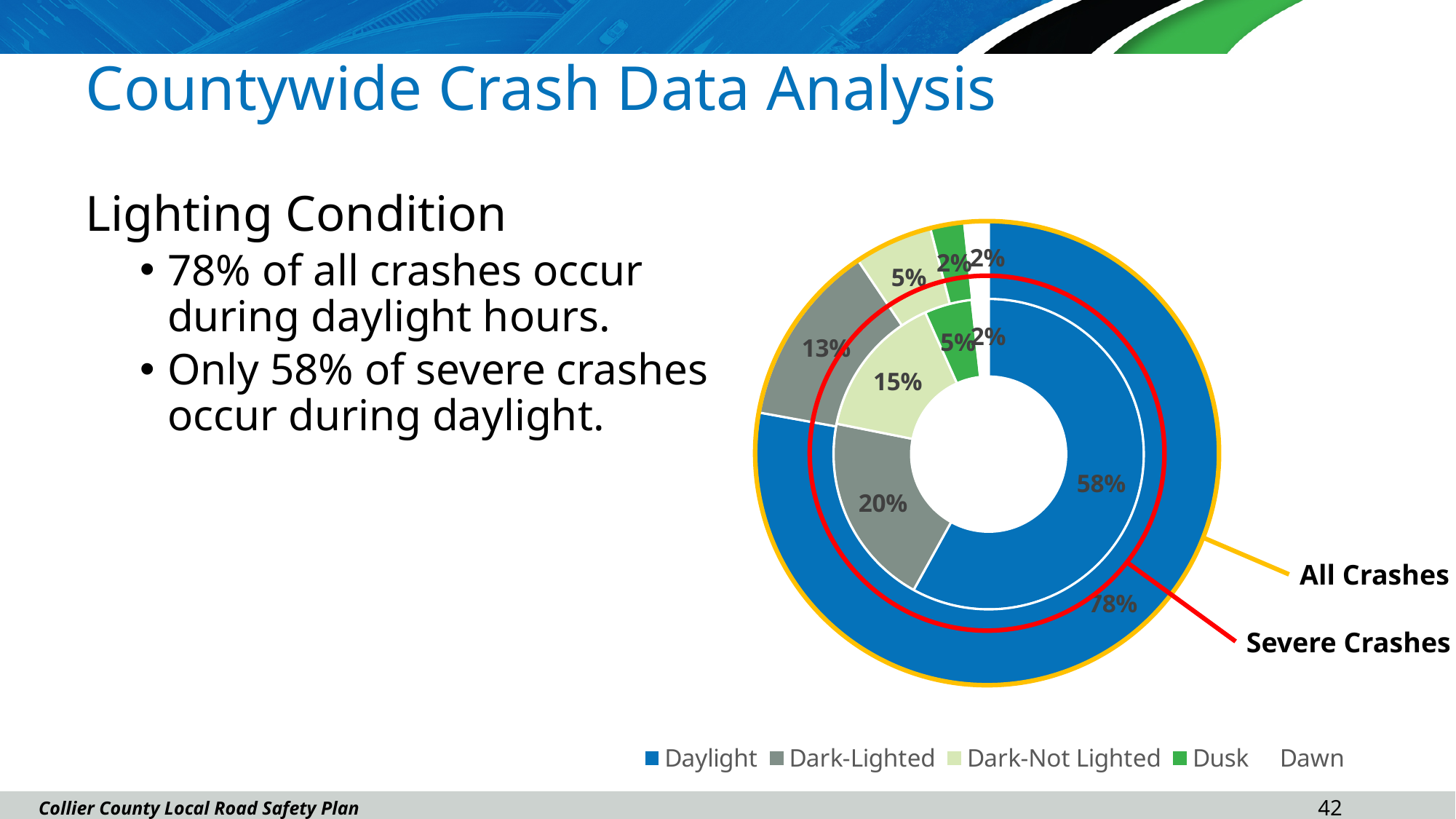
What percentage of Severe Crashes occurred under Dark-Not Lighted conditions? 15% How many lighting condition categories does the legend list? 5 How many percentage points higher is the Daylight share for All Crashes than for Severe Crashes? 20 percentage points What percentage of All Crashes (outer ring) occurred in Daylight? 78% What percentage of Severe Crashes (inner ring) occurred in Daylight? 58% What percentage of All Crashes occurred under Dark-Lighted conditions? 13% What percentage of Severe Crashes occurred at Dusk? 5% What percentage of All Crashes occurred under Dark-Not Lighted conditions? 5% What kind of chart is shown on the slide? Doughnut chart Is the Dark-Lighted share larger for All Crashes or for Severe Crashes? Severe Crashes Which lighting condition has the largest share of Severe Crashes? Daylight What percentage of Severe Crashes occurred under Dark-Lighted conditions? 20%